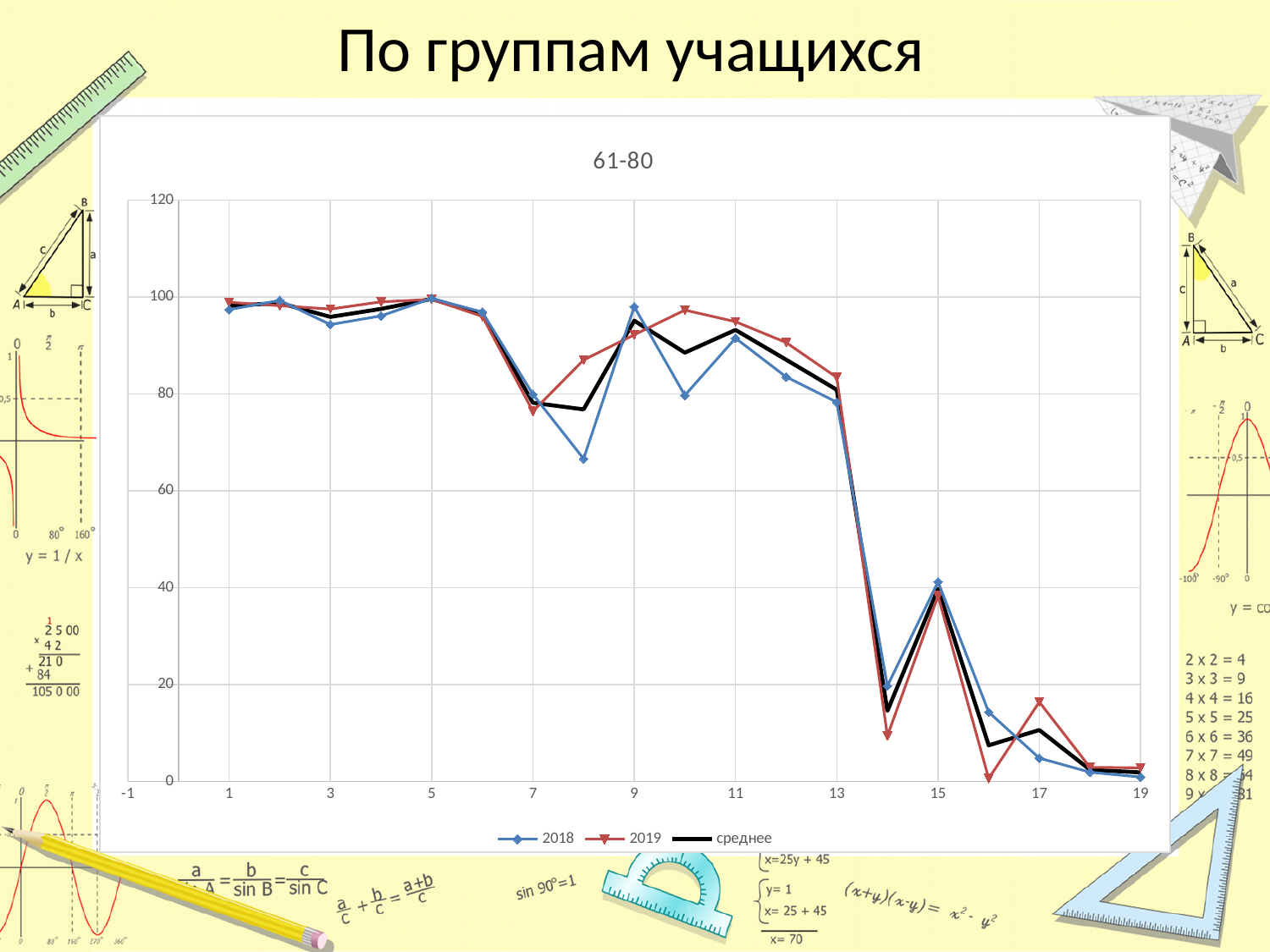
Overall, do the values rise or fall from x = 1 to x = 19? fall What are the series names listed in the legend? 2018, 2019, среднее What is the title of the chart? 61-80 Is the value for 2019 at x = 10 greater or less than 80? greater At x = 8, which series has the larger value, 2018 or 2019? 2019 At x = 17, which series has the larger value, 2018 or 2019? 2019 Is the value for 2018 at x = 15 greater or less than 20? greater At x = 14, which series has the larger value, 2018 or 2019? 2018 How many series does the legend list? 3 Is the value for 2019 at x = 16 greater or less than 20? less What kind of chart is shown on the slide? line chart